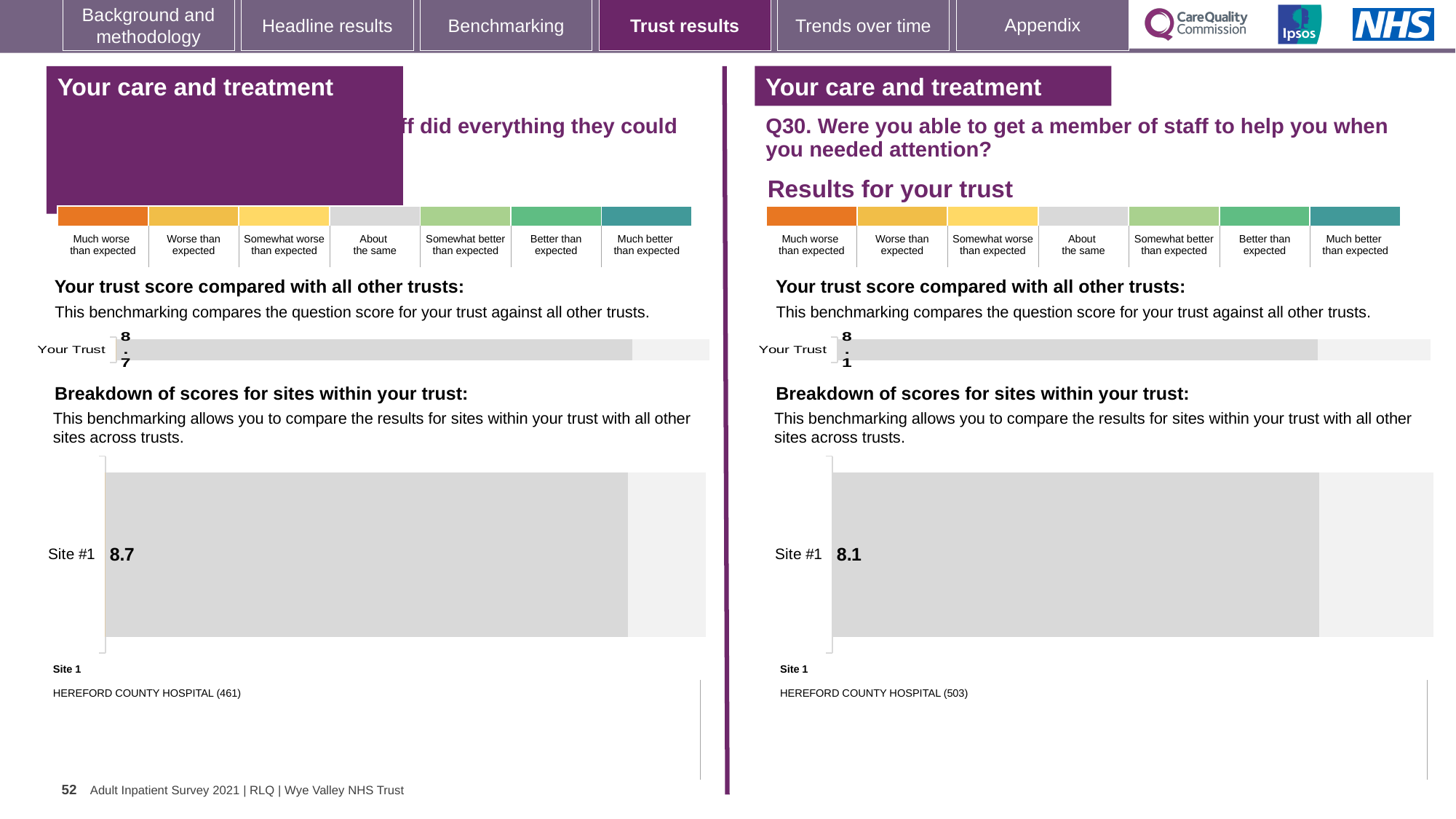
In the right-hand panel (Q30), which hospital is listed as Site 1 below the site breakdown chart? HEREFORD COUNTY HOSPITAL (503) Is the Your Trust score in the right-hand panel (Q30) the same as the Site #1 score in that panel? Yes, both are 8.1 How many sites are plotted in the 'Breakdown of scores for sites within your trust' chart in the right-hand panel (Q30)? 1 In the right-hand panel (Q30), what is the value shown for Your Trust in the 'Your trust score compared with all other trusts' chart? 8.1 In the right-hand panel (Q30), what score is shown for Site #1 in the 'Breakdown of scores for sites within your trust' chart? 8.1 In the left-hand panel, what is the value shown for Your Trust in the 'Your trust score compared with all other trusts' chart? 8.7 Which is larger: the Site #1 score in the left-hand panel or the Site #1 score in the right-hand panel (Q30)? Left-hand panel (8.7) How many sites are plotted in the 'Breakdown of scores for sites within your trust' chart in the left-hand panel? 1 What type of chart is used to show the Site #1 score in the 'Breakdown of scores for sites within your trust' section of the right-hand panel? Bar chart In the left-hand panel, what score is shown for Site #1 in the 'Breakdown of scores for sites within your trust' chart? 8.7 In the left-hand panel, which hospital is listed as Site 1 below the site breakdown chart? HEREFORD COUNTY HOSPITAL (461) What is the difference between the Site #1 score in the left-hand panel (8.7) and the Site #1 score in the right-hand panel (8.1)? 0.6